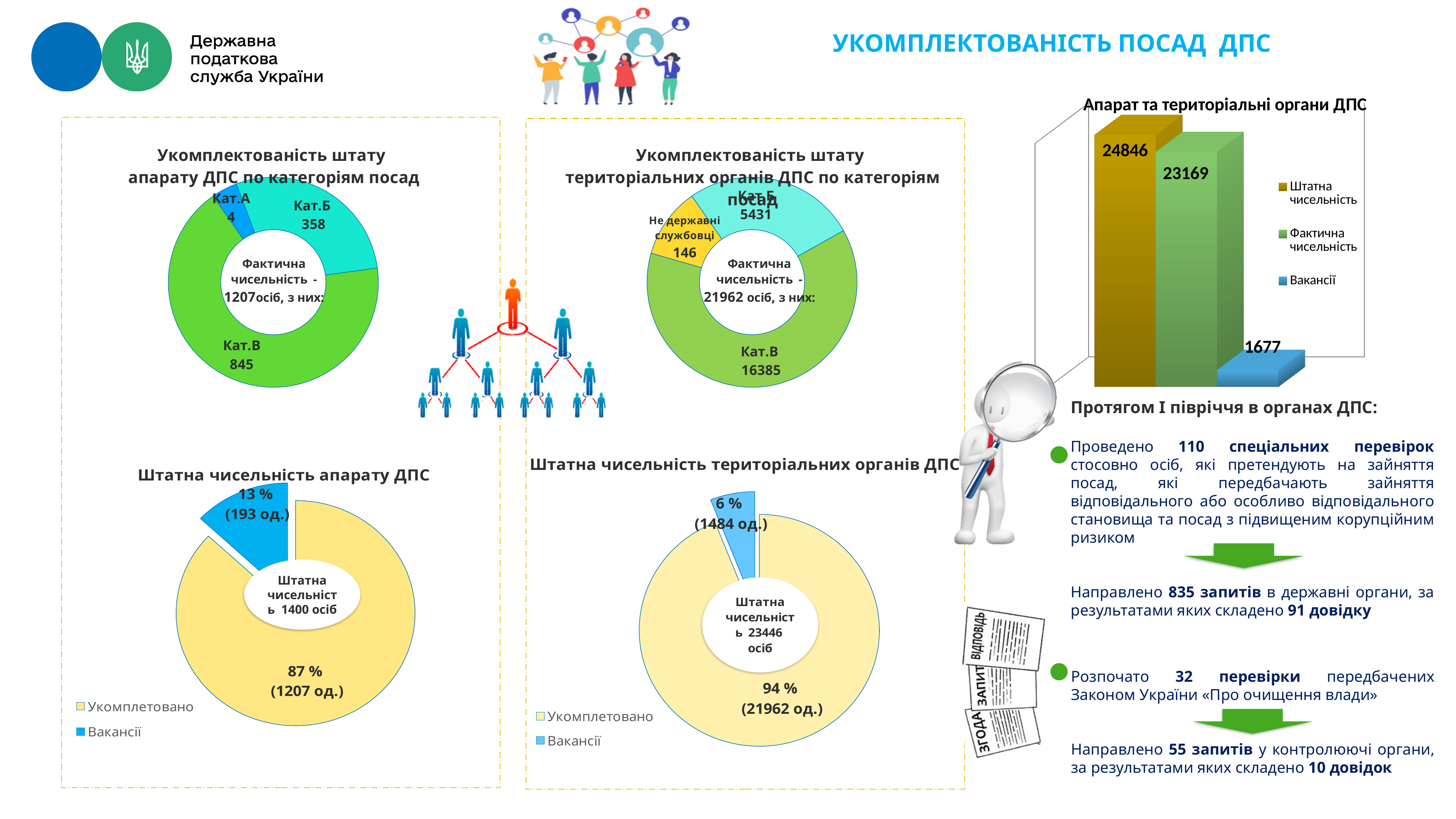
In the chart 'Укомплектованість штату територіальних органів ДПС по категоріям посад', which category has the highest value? Кат.В In the chart 'Штатна чисельність територіальних органів ДПС', what share of the pie is Укомплектовано? 94 % In the chart 'Штатна чисельність апарату ДПС', what share of the pie is Вакансії? 13 % In the chart 'Апарат та територіальні органи ДПС', what is the value for Фактична чисельність? 23169 In the chart 'Укомплектованість штату територіальних органів ДПС по категоріям посад', how many categories are shown? 3 In the chart 'Апарат та територіальні органи ДПС', what is the difference between Штатна чисельність and Фактична чисельність? 1677 In the chart 'Штатна чисельність апарату ДПС', what is the value in units for Укомплектовано? 1207 од. In the chart 'Укомплектованість штату апарату ДПС по категоріям посад', what is the value for Кат.В? 845 In the chart 'Штатна чисельність територіальних органів ДПС', what is the value in units for Вакансії? 1484 од. In the chart 'Укомплектованість штату апарату ДПС по категоріям посад', which category has the lowest value? Кат.А In the chart 'Укомплектованість штату територіальних органів ДПС по категоріям посад', what is the value for Кат.Б? 5431 In the chart 'Укомплектованість штату апарату ДПС по категоріям посад', what is the difference between Кат.В and Кат.Б? 487